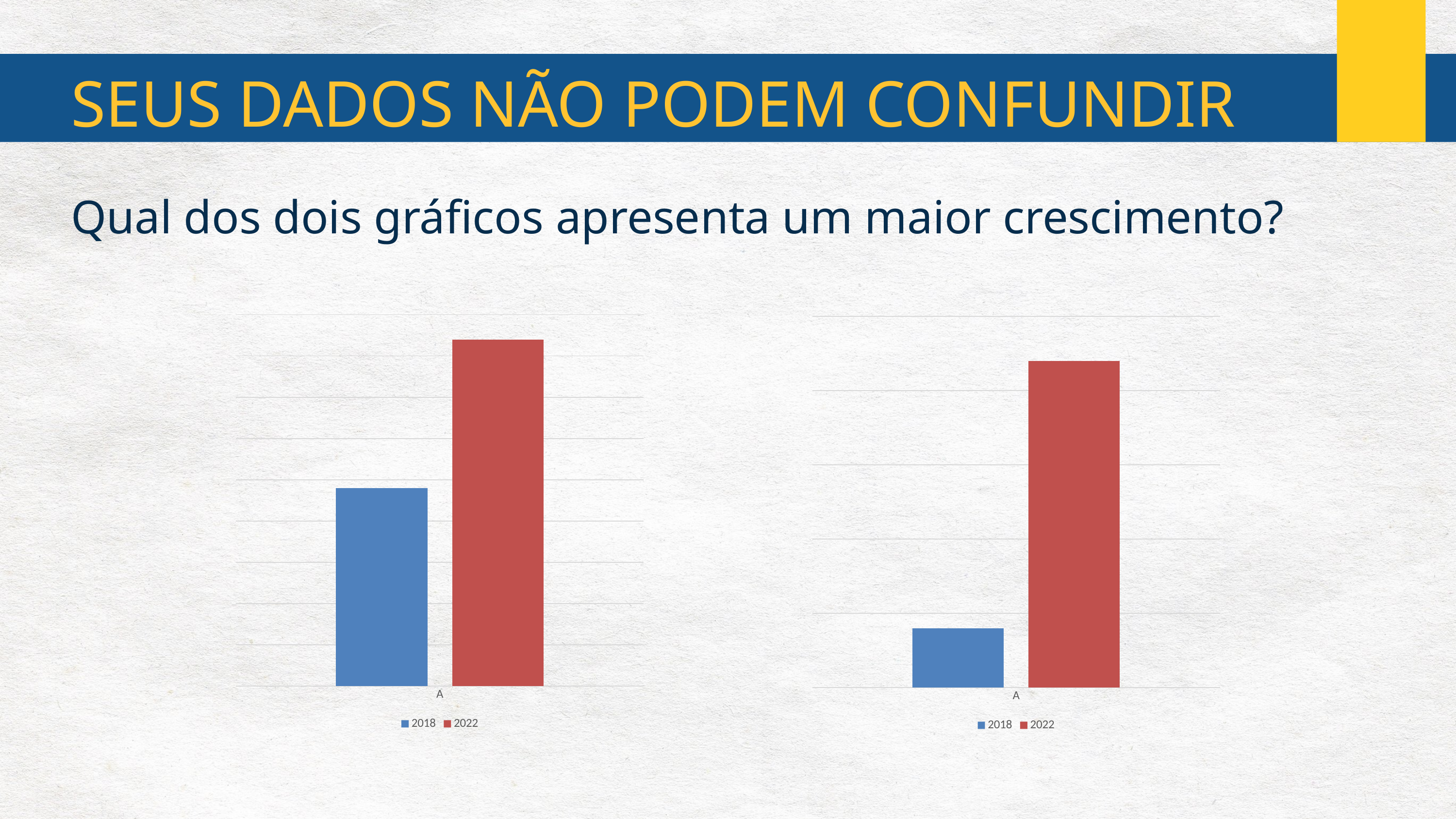
How many series does the legend of the right chart list? 2 In the left chart, which series has the lowest bar? 2018 What are the legend entries of the left chart? 2018, 2022 In the right chart, which series has the taller bar for category A, 2018 or 2022? 2022 What kind of chart is the left chart? bar chart In the right chart, what colour is the bar for the 2022 series? red What kind of chart is the right chart? bar chart In the right chart, which series has the highest bar? 2022 How many categories are shown on the x axis of the right chart? 1 How many categories are shown on the x axis of the left chart? 1 How many series does the legend of the left chart list? 2 In the left chart, which series has the taller bar for category A, 2018 or 2022? 2022